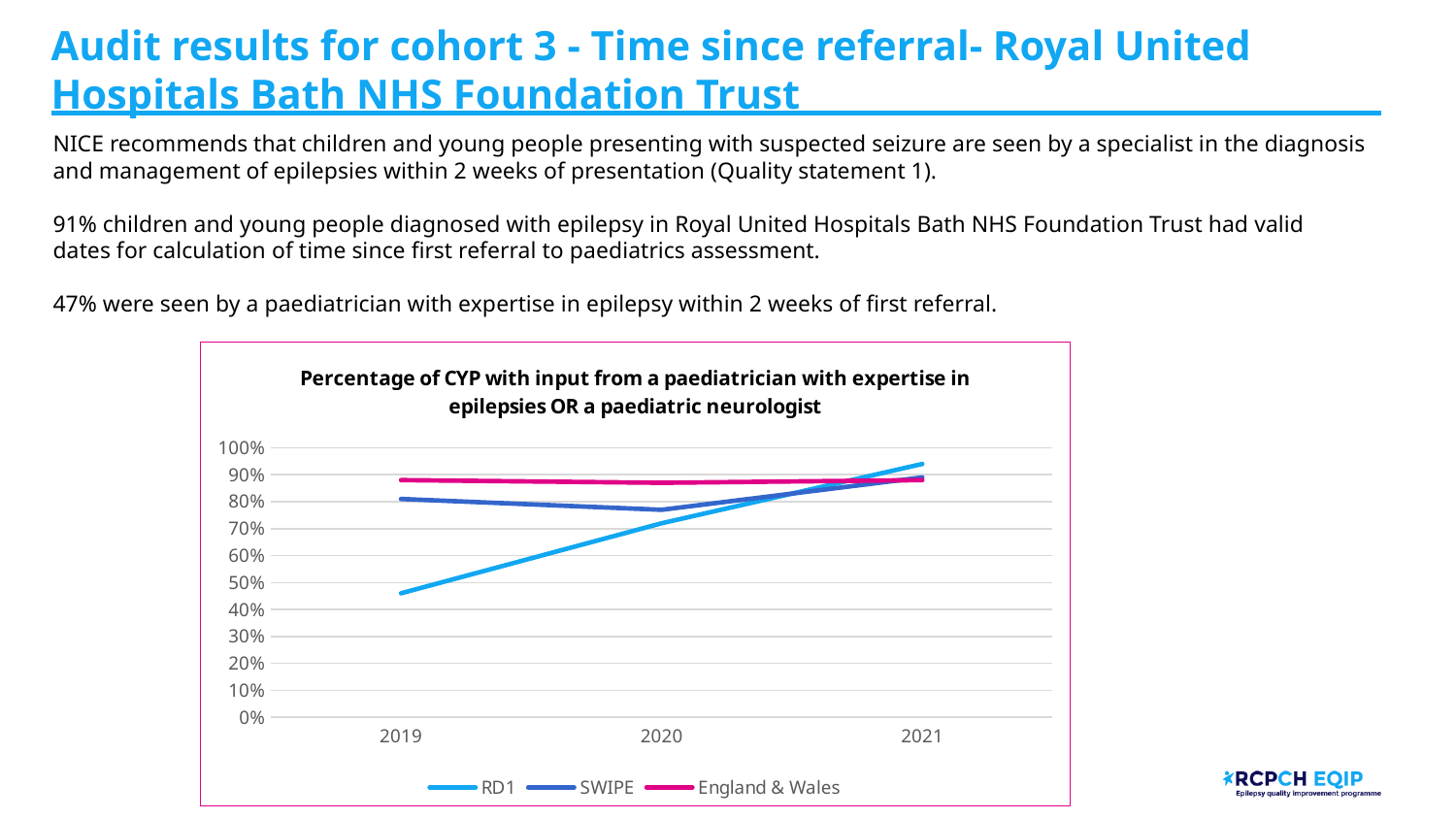
Is the value for England & Wales in 2019 greater or less than 80%? greater Is the value for RD1 in 2019 greater or less than 50%? less Which series has the highest value in 2019? England & Wales Does the RD1 line rise or fall from 2019 to 2021? rise Is the value for RD1 in 2021 greater or less than 90%? greater How many series does the chart legend list? 3 What kind of chart is shown on the slide? line chart In 2019, which is larger: the value for RD1 or the value for SWIPE? SWIPE Which series has the lowest value in 2019? RD1 What is the title of the chart? Percentage of CYP with input from a paediatrician with expertise in epilepsies OR a paediatric neurologist How many years are shown along the x axis of the chart? 3